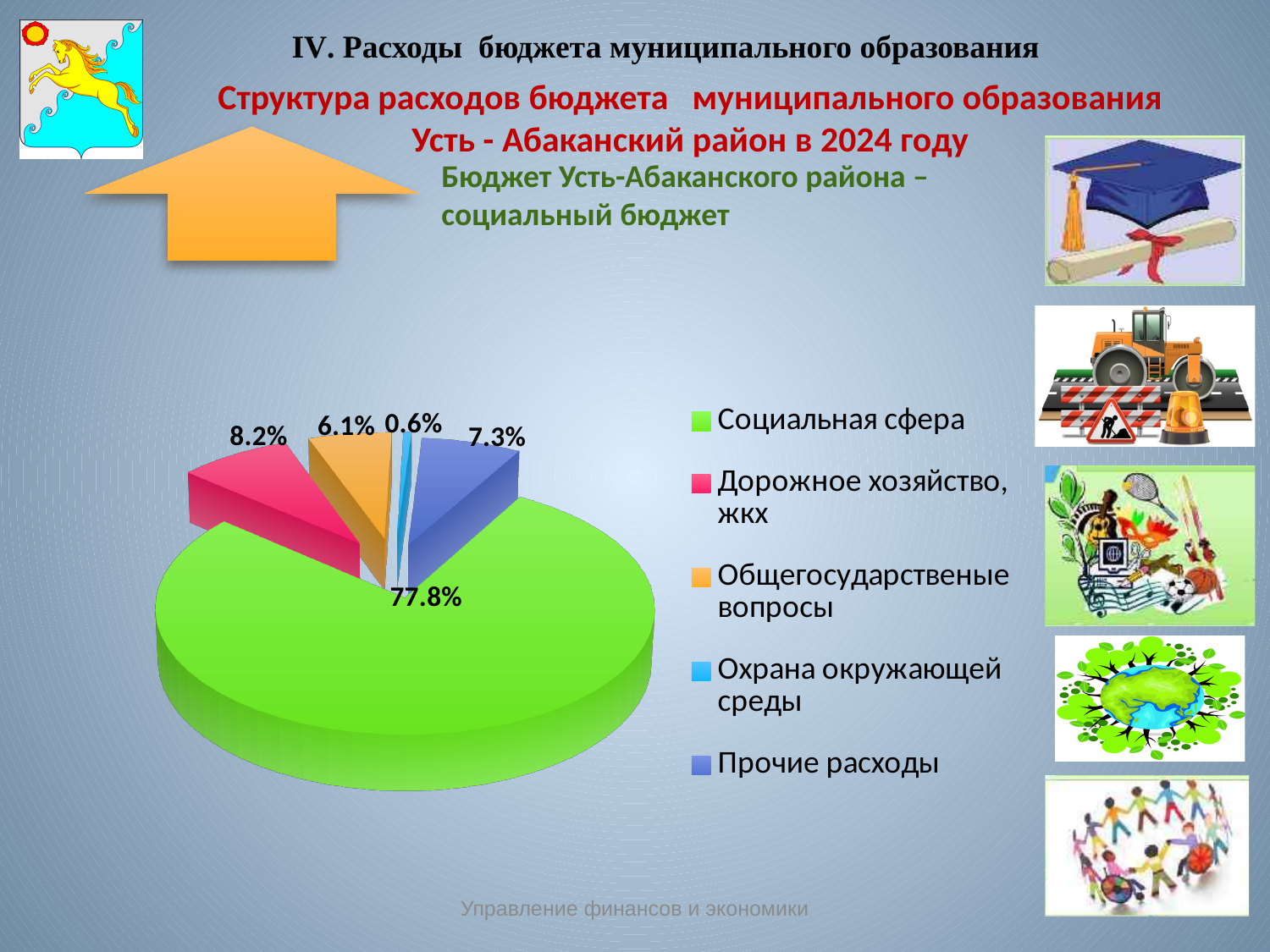
What share of the pie chart does "Дорожное хозяйство, жкх" have? 8.2% What share of the pie chart does "Общегосударственые вопросы" have? 6.1% Which category has the smallest slice of the pie chart? Охрана окружающей среды Which category has the largest slice of the pie chart? Социальная сфера What share of the pie chart does "Социальная сфера" have? 77.8% What share of the pie chart does "Прочие расходы" have? 7.3% How many categories does the pie chart show? 5 What share of the pie chart does "Охрана окружающей среды" have? 0.6% What is the difference between the shares of "Дорожное хозяйство, жкх" and "Прочие расходы"? 0.9% What kind of chart is shown on the slide? Pie chart What colour is the slice for "Социальная сфера"? Green Which is larger: the share of "Общегосударственые вопросы" or the share of "Прочие расходы"? Прочие расходы